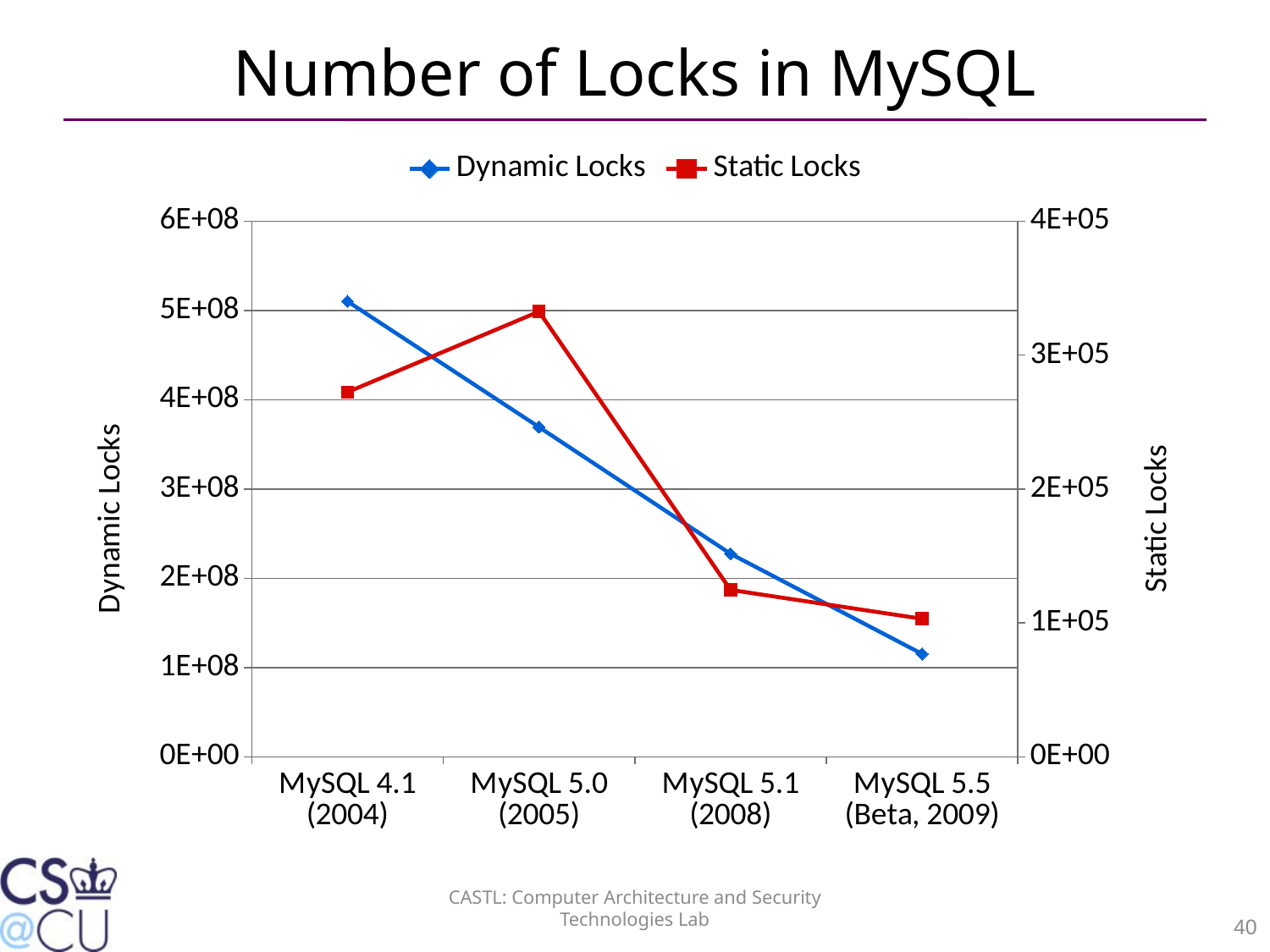
Is the Static Locks value for MySQL 5.0 (2005) greater or less than 3E+05? greater How many series does the legend list? 2 Do the Dynamic Locks values rise or fall from MySQL 4.1 to MySQL 5.5? Fall How many MySQL versions are plotted along the x axis? 4 Is the Static Locks value for MySQL 4.1 (2004) greater or less than 3E+05? less Which MySQL version has the lowest number of Dynamic Locks? MySQL 5.5 (Beta, 2009) Is the Dynamic Locks value for MySQL 5.0 (2005) greater or less than 4E+08? less Which MySQL version has the highest number of Dynamic Locks? MySQL 4.1 (2004) What is the label of the right-hand vertical axis? Static Locks Which MySQL version has the highest number of Static Locks? MySQL 5.0 (2005) What type of chart is shown on the slide? Line chart Which has more Static Locks, MySQL 4.1 (2004) or MySQL 5.1 (2008)? MySQL 4.1 (2004)